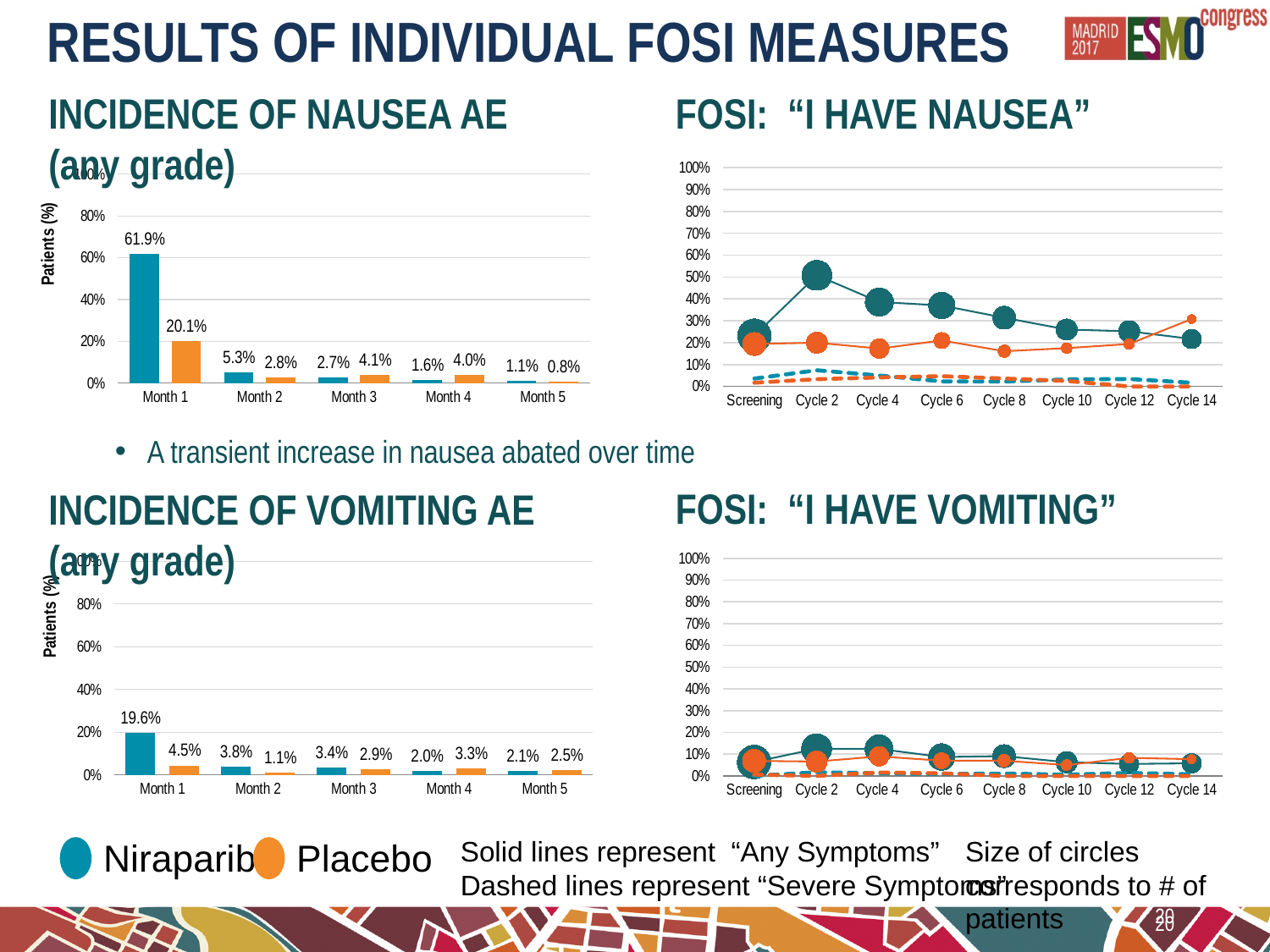
In the 'Incidence of Vomiting AE (any grade)' chart, what is the value for Placebo at Month 4? 3.3% What kind of chart is the 'Incidence of Nausea AE (any grade)' chart? Bar chart In the 'Incidence of Nausea AE (any grade)' chart, which month has the highest Niraparib value? Month 1 In the 'Incidence of Vomiting AE (any grade)' chart, what is the value for Niraparib at Month 1? 19.6% In the 'Incidence of Vomiting AE (any grade)' chart, how many months are shown on the x axis? 5 In the 'Incidence of Nausea AE (any grade)' chart, what is the difference between the Niraparib and Placebo values at Month 1? 41.8% In the 'Incidence of Nausea AE (any grade)' chart, what is the value for Placebo at Month 3? 4.1% In the 'FOSI: I have nausea' chart, is the Niraparib solid-line value at Cycle 2 greater or less than 40%? greater In the 'Incidence of Nausea AE (any grade)' chart, which month has the lowest Placebo value? Month 5 In the 'Incidence of Nausea AE (any grade)' chart, what is the value for Niraparib at Month 1? 61.9% In the 'Incidence of Vomiting AE (any grade)' chart, which is larger at Month 2, Niraparib or Placebo? Niraparib In the 'FOSI: I have vomiting' chart, is the Niraparib solid-line value at Cycle 2 greater or less than 30%? less